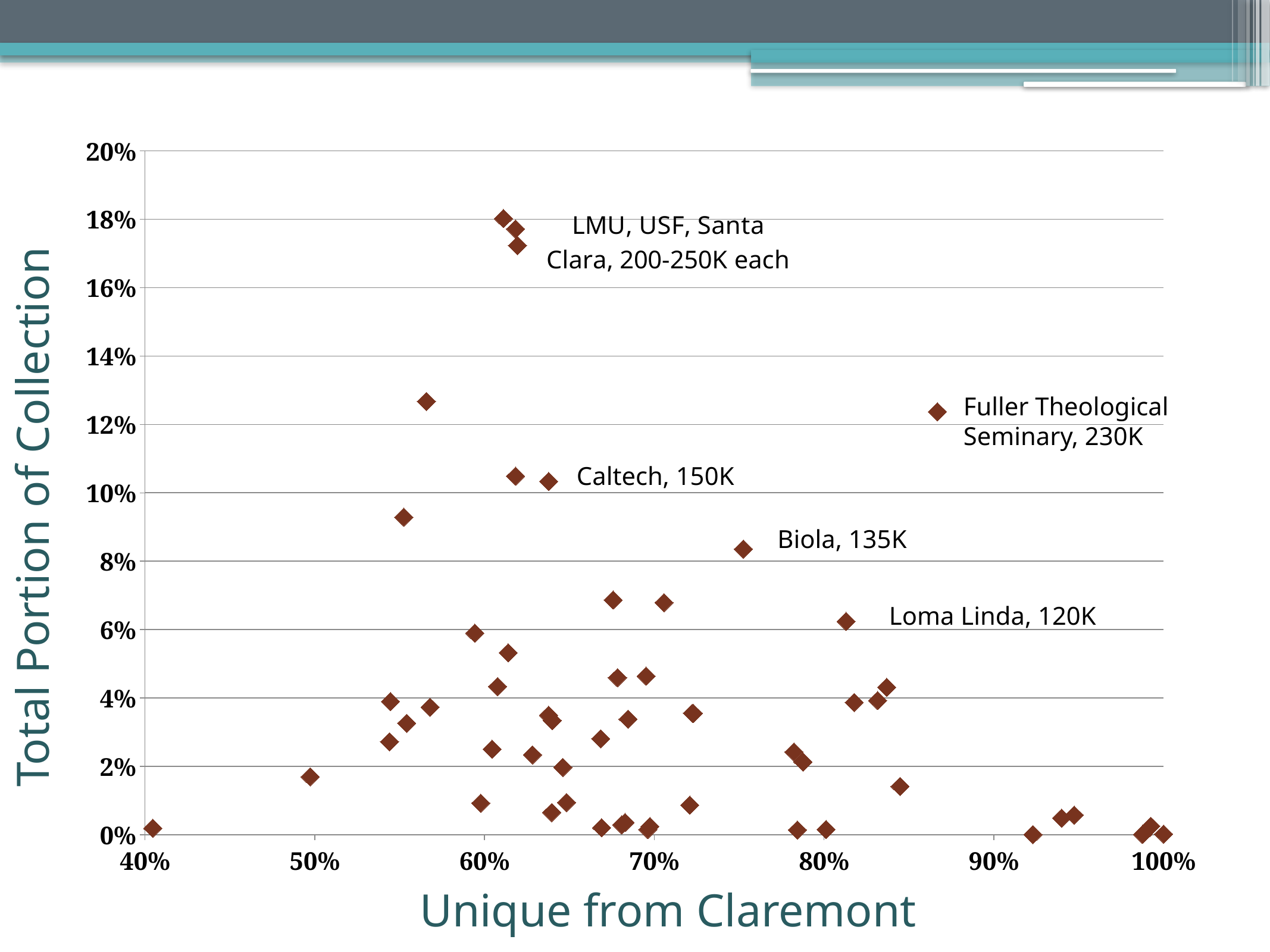
What collection size is annotated next to the Biola point? 135K Which labelled group of points has the highest Total Portion of Collection? LMU, USF, Santa Clara Is the Unique from Claremont value for Biola greater or less than 70%? greater What is the title of the y axis? Total Portion of Collection Is the Total Portion of Collection for Fuller Theological Seminary greater or less than 10%? greater What kind of chart is shown on the slide? scatter chart What collection size is annotated for Fuller Theological Seminary? 230K What collection size range is annotated for LMU, USF and Santa Clara? 200-250K each What collection size is annotated for Loma Linda? 120K What collection size is annotated next to the Caltech point? 150K What is the title of the x axis? Unique from Claremont Which has a higher Total Portion of Collection, Caltech or Loma Linda? Caltech